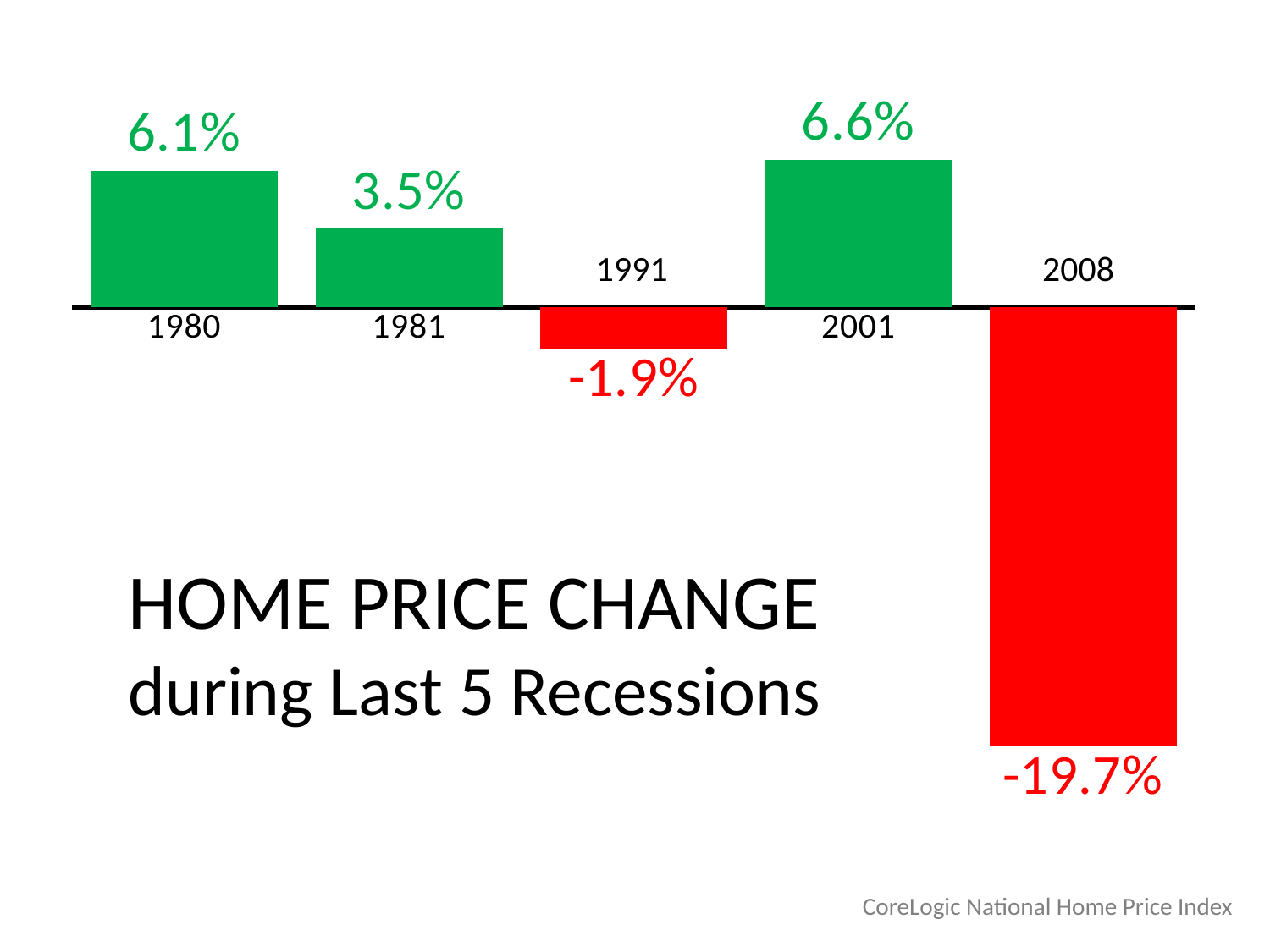
What was the home price change during the 1991 recession? -1.9% What kind of chart is shown on the slide? Bar chart How many recessions show a negative home price change? 2 Which recession shows the highest home price change? 2001 What was the home price change during the 2008 recession? -19.7% How many recessions are shown in the chart? 5 Which recession had a larger home price change, 1980 or 1981? 1980 What is the difference between the home price change in 2001 and in 1981? 3.1% What is the title of the chart? HOME PRICE CHANGE during Last 5 Recessions Which recession shows the lowest home price change? 2008 What colour are the bars with negative home price changes? Red What was the home price change during the 1980 recession? 6.1%